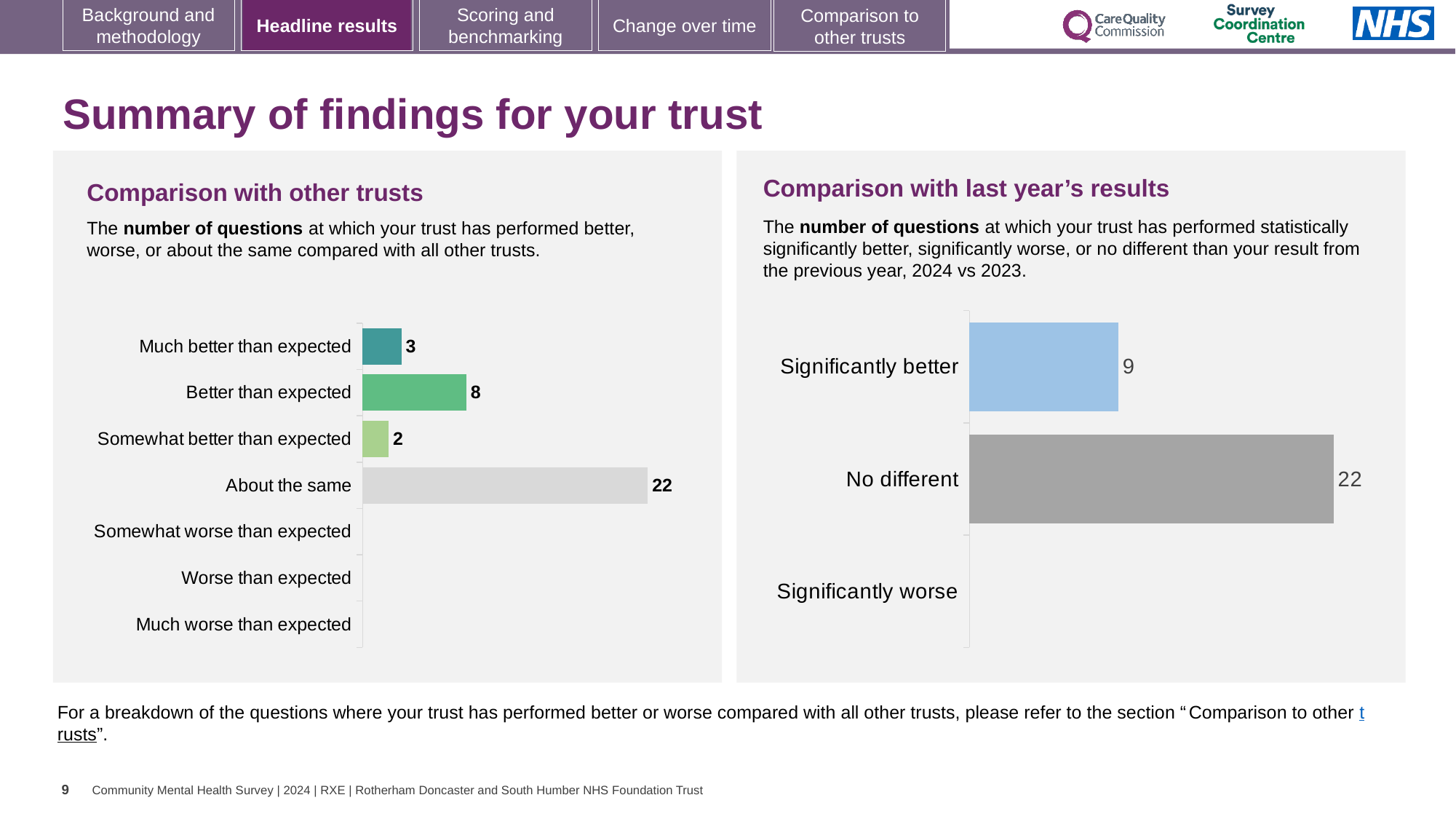
In the 'Comparison with other trusts' chart, how many categories are listed on the axis? 7 In the 'Comparison with other trusts' chart, what is the difference between 'Better than expected' and 'Somewhat better than expected'? 6 In the 'Comparison with other trusts' chart, which category has the highest value? About the same In the 'Comparison with other trusts' chart, how many questions were 'About the same'? 22 In the 'Comparison with other trusts' chart, how many questions were 'Better than expected'? 8 In the 'Comparison with last year's results' chart, which is larger: 'Significantly better' or 'No different'? No different What type of chart is the 'Comparison with last year's results' chart? Bar chart In the 'Comparison with last year's results' chart, what is the difference between 'No different' and 'Significantly better'? 13 In the 'Comparison with last year's results' chart, how many questions were 'No different'? 22 In the 'Comparison with other trusts' chart, how many questions were 'Much better than expected'? 3 In the 'Comparison with other trusts' chart, what is the total number of questions across 'Much better than expected', 'Better than expected' and 'Somewhat better than expected'? 13 In the 'Comparison with last year's results' chart, how many questions were 'Significantly better'? 9